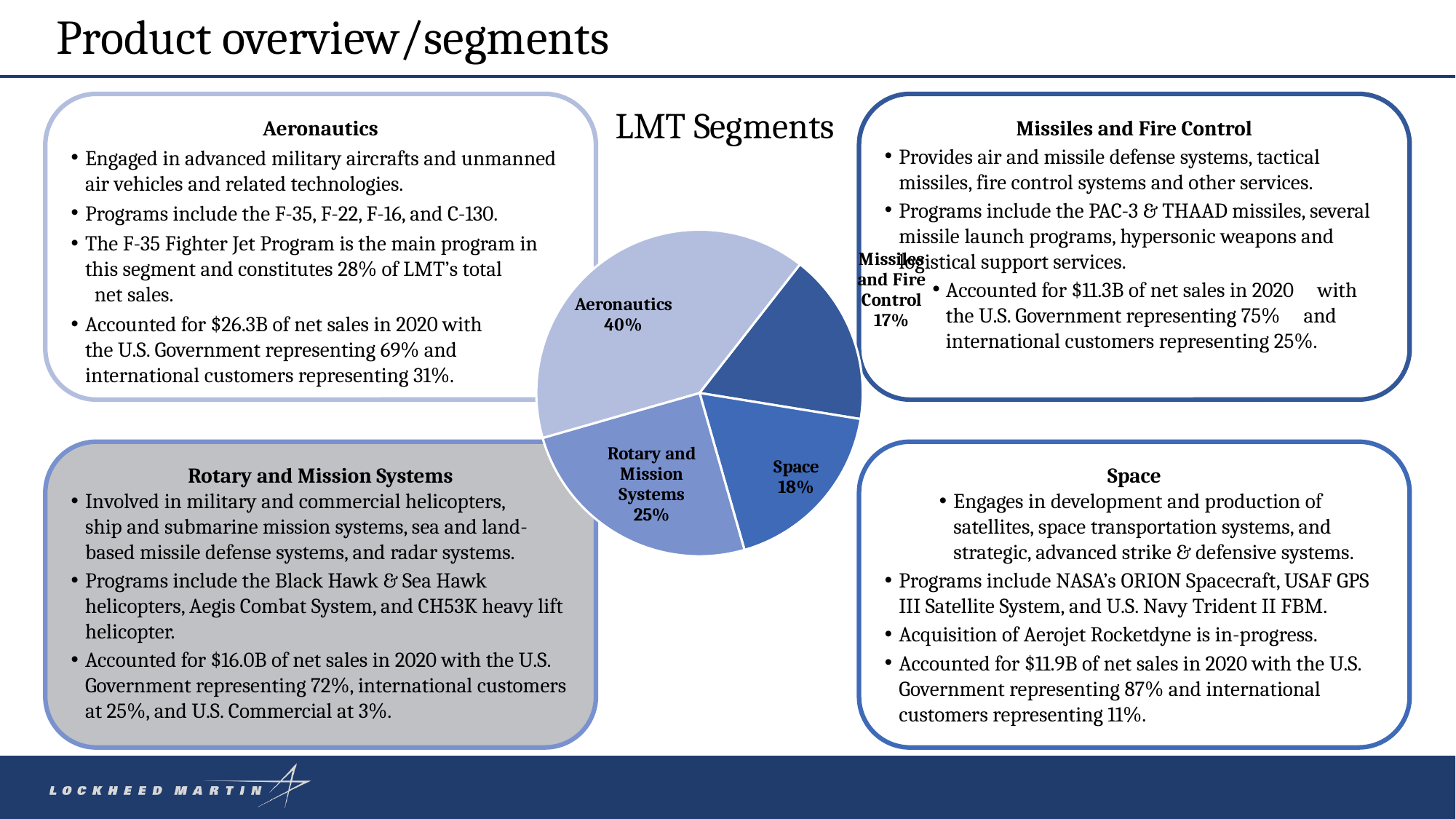
What share of the pie does Space represent? 18% What type of chart is shown on the slide? pie chart What is the difference in percentage points between Aeronautics and Rotary and Mission Systems? 15 What share of the pie does Missiles and Fire Control represent? 17% What is the title of the chart? LMT Segments What is the combined share of Space and Missiles and Fire Control? 35% Which segment has the smallest share of the pie? Missiles and Fire Control Which is larger, the share for Space or the share for Rotary and Mission Systems? Rotary and Mission Systems What share of the pie does Rotary and Mission Systems represent? 25% What share of the pie does Aeronautics represent? 40% How many segments are shown in the pie chart? 4 Which segment has the largest share of the pie? Aeronautics